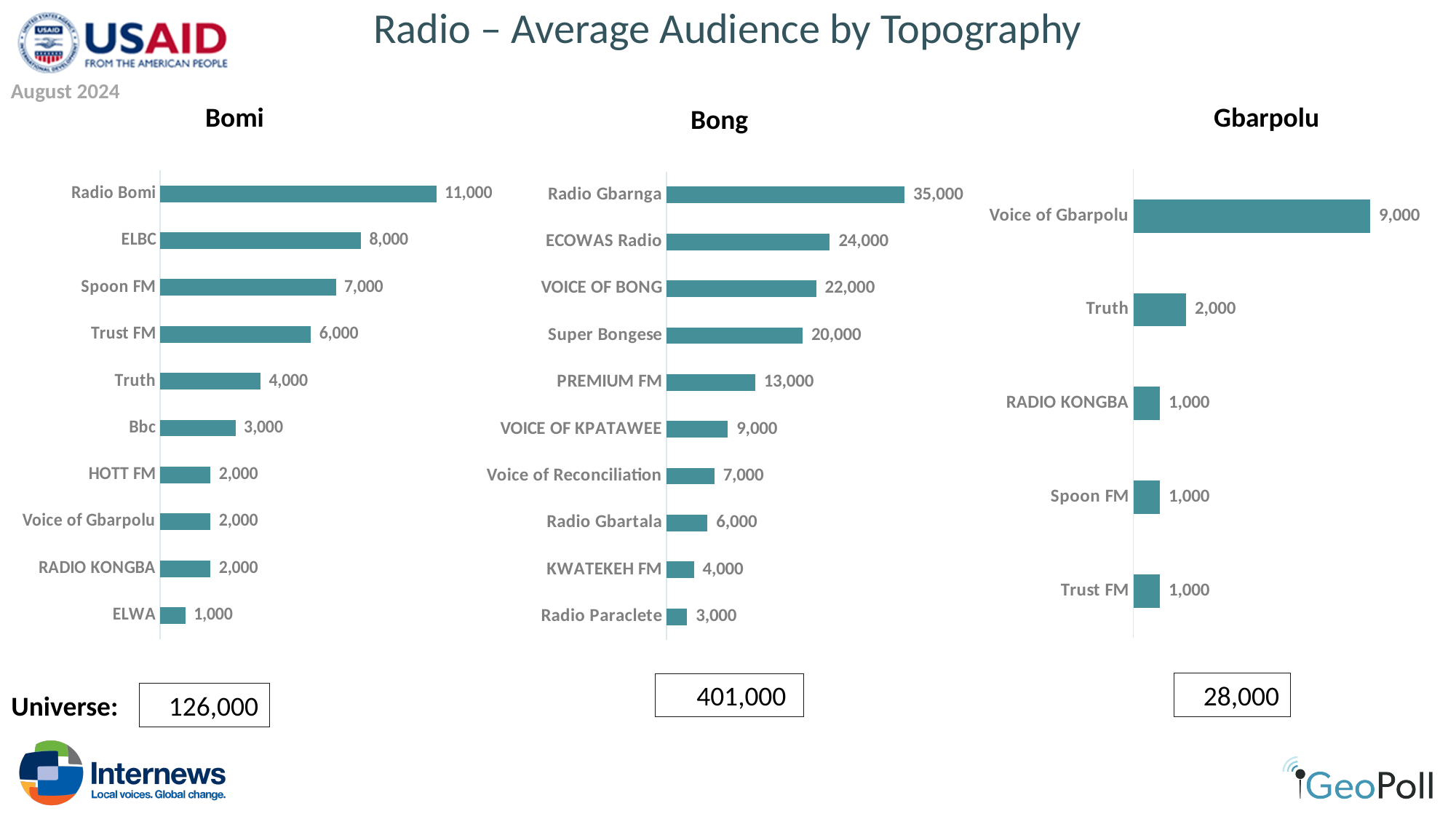
How many stations are shown in the Gbarpolu chart? 5 What type of chart is used for the Bomi data? Bar chart In the Bomi chart, what is the difference between the average audience of ELBC and Bbc? 5,000 How many stations are shown in the Bong chart? 10 In the Bomi chart, which has a larger average audience, Spoon FM or Trust FM? Spoon FM In the Bong chart, what is the average audience for ECOWAS Radio? 24,000 In the Bomi chart, what is the average audience for Radio Bomi? 11,000 In the Bong chart, which station has the highest average audience? Radio Gbarnga What is the Universe value shown for Bong? 401,000 In the Gbarpolu chart, what is the average audience for Truth? 2,000 In the Bomi chart, which station has the lowest average audience? ELWA In the Bong chart, what is the difference between the average audience of Radio Gbarnga and Super Bongese? 15,000